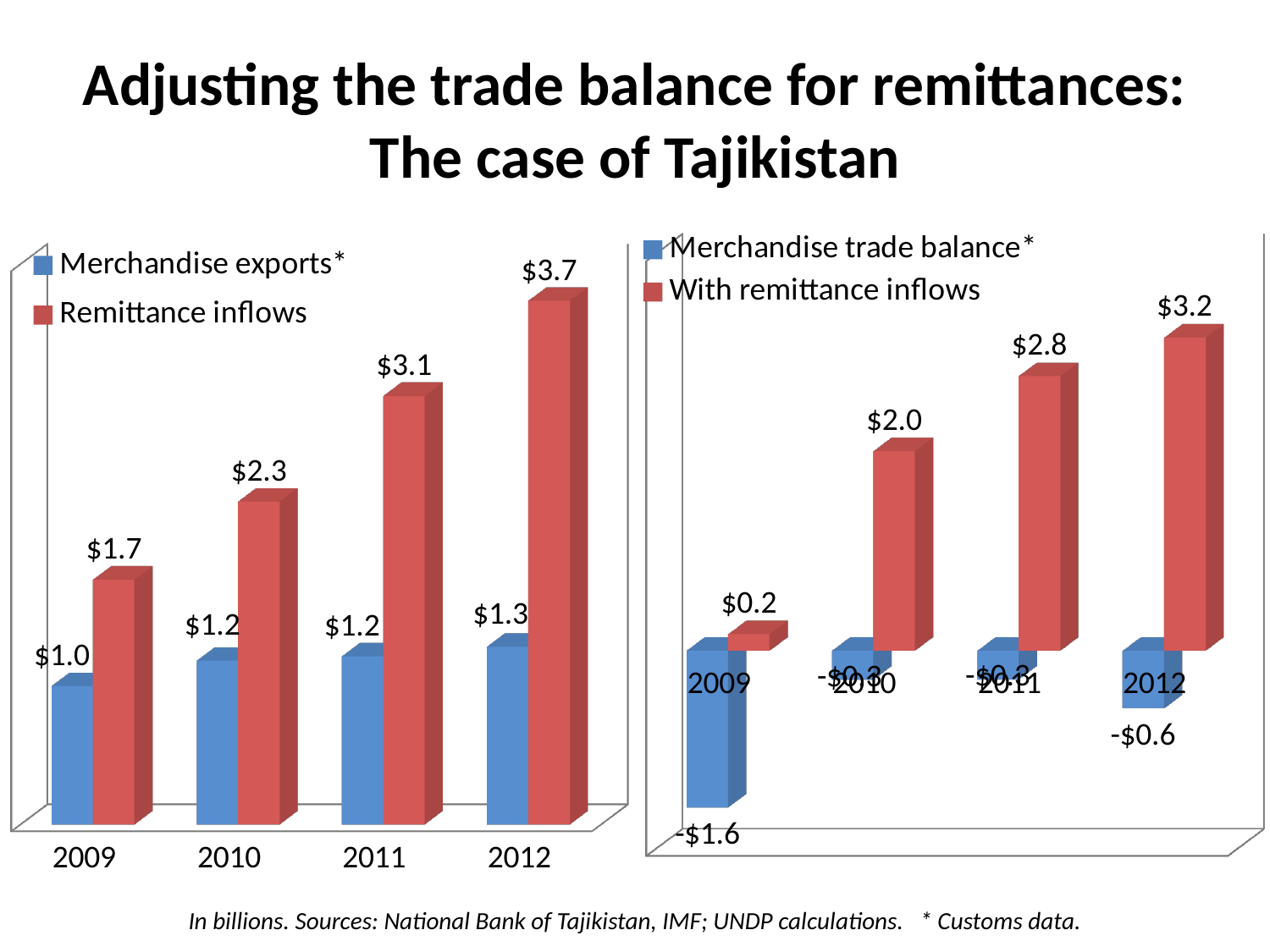
In the left chart, which year has the highest Remittance inflows? 2012 In the left chart, what is the value of Merchandise exports* for 2009? $1.0 In the right chart, what is the value of With remittance inflows for 2011? $2.8 In the left chart, which year has the lowest Merchandise exports*? 2009 In the left chart, what is the value of Remittance inflows for 2012? $3.7 How many series does the legend of the right chart list? 2 In the right chart, what is the Merchandise trade balance* for 2009? -$1.6 In the left chart, do Remittance inflows rise or fall from 2009 to 2012? rise In the right chart, which is larger: With remittance inflows in 2010 or in 2012? 2012 What type of chart is the left chart? bar chart In the right chart, which year has the lowest Merchandise trade balance*? 2009 In the left chart, what is the difference between Remittance inflows and Merchandise exports* in 2011? $1.9